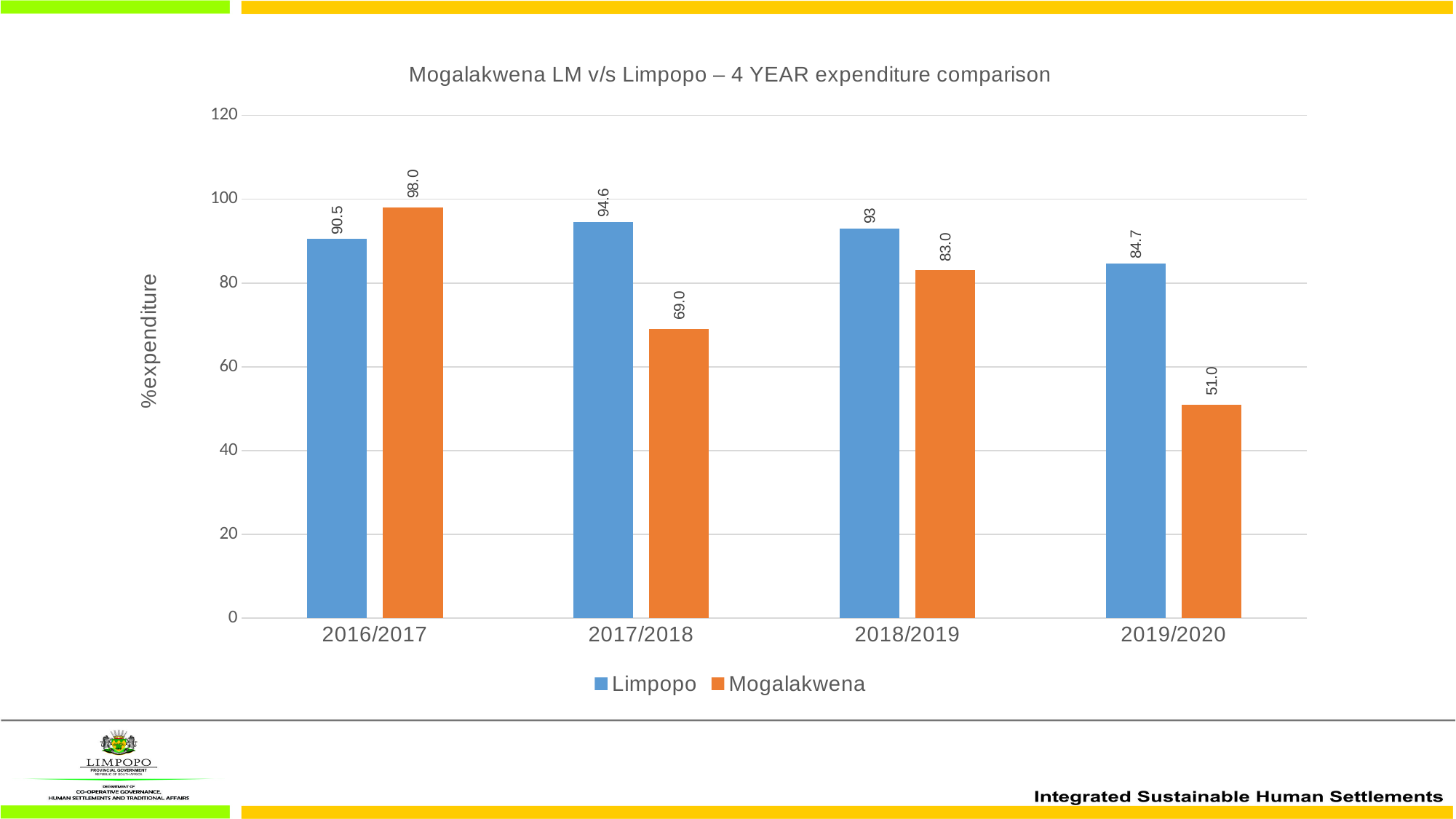
What kind of chart is this? Bar chart What is the Limpopo value for 2018/2019? 93 In which year is the Mogalakwena value highest? 2016/2017 What is the Mogalakwena value for 2017/2018? 69.0 What is the difference between the Limpopo and Mogalakwena values in 2019/2020? 33.7 In which year is the Limpopo value lowest? 2019/2020 Which is larger in 2016/2017, Limpopo or Mogalakwena? Mogalakwena What is the Mogalakwena value for 2019/2020? 51.0 How many years are shown on the x axis? 4 Does the Mogalakwena value rise or fall from 2017/2018 to 2019/2020? Fall What is the Limpopo value for 2016/2017? 90.5 How many series does the legend list? 2